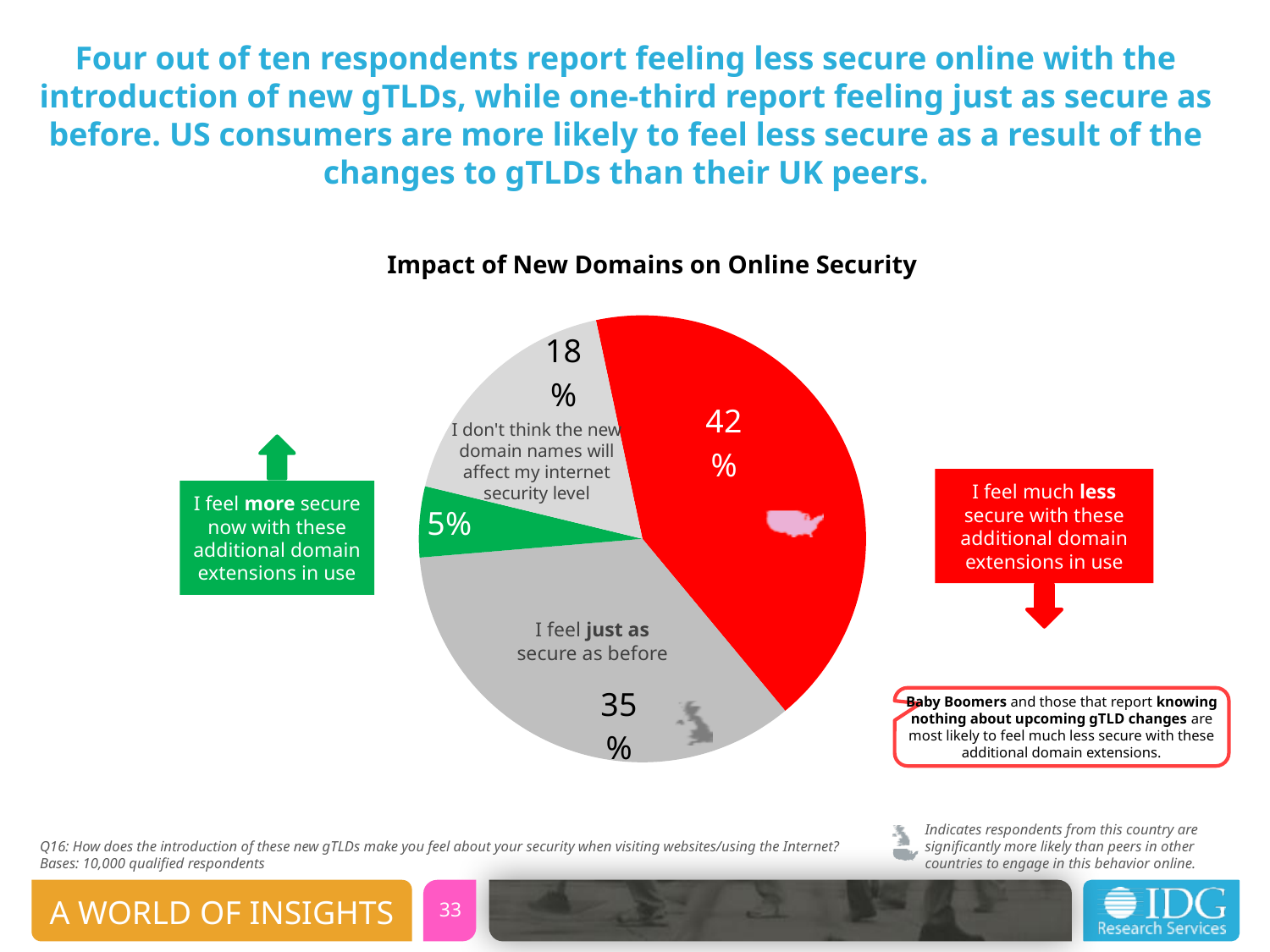
What percentage of respondents feel more secure now with these additional domain extensions in use? 5% What type of chart is shown on the slide? Pie chart What percentage of respondents feel much less secure with these additional domain extensions in use? 42% Which is larger: the share who feel just as secure as before or the share who don't think the new domain names will affect their security level? I feel just as secure as before What is the difference in percentage points between those who feel much less secure and those who feel just as secure as before? 7 What is the title of the chart? Impact of New Domains on Online Security What percentage of respondents feel just as secure as before? 35% What percentage of respondents don't think the new domain names will affect their internet security level? 18% What colour is the slice for respondents who feel much less secure? Red Which response has the largest share of the pie? I feel much less secure with these additional domain extensions in use Which response has the smallest share of the pie? I feel more secure now with these additional domain extensions in use How many slices does the pie chart have? 4